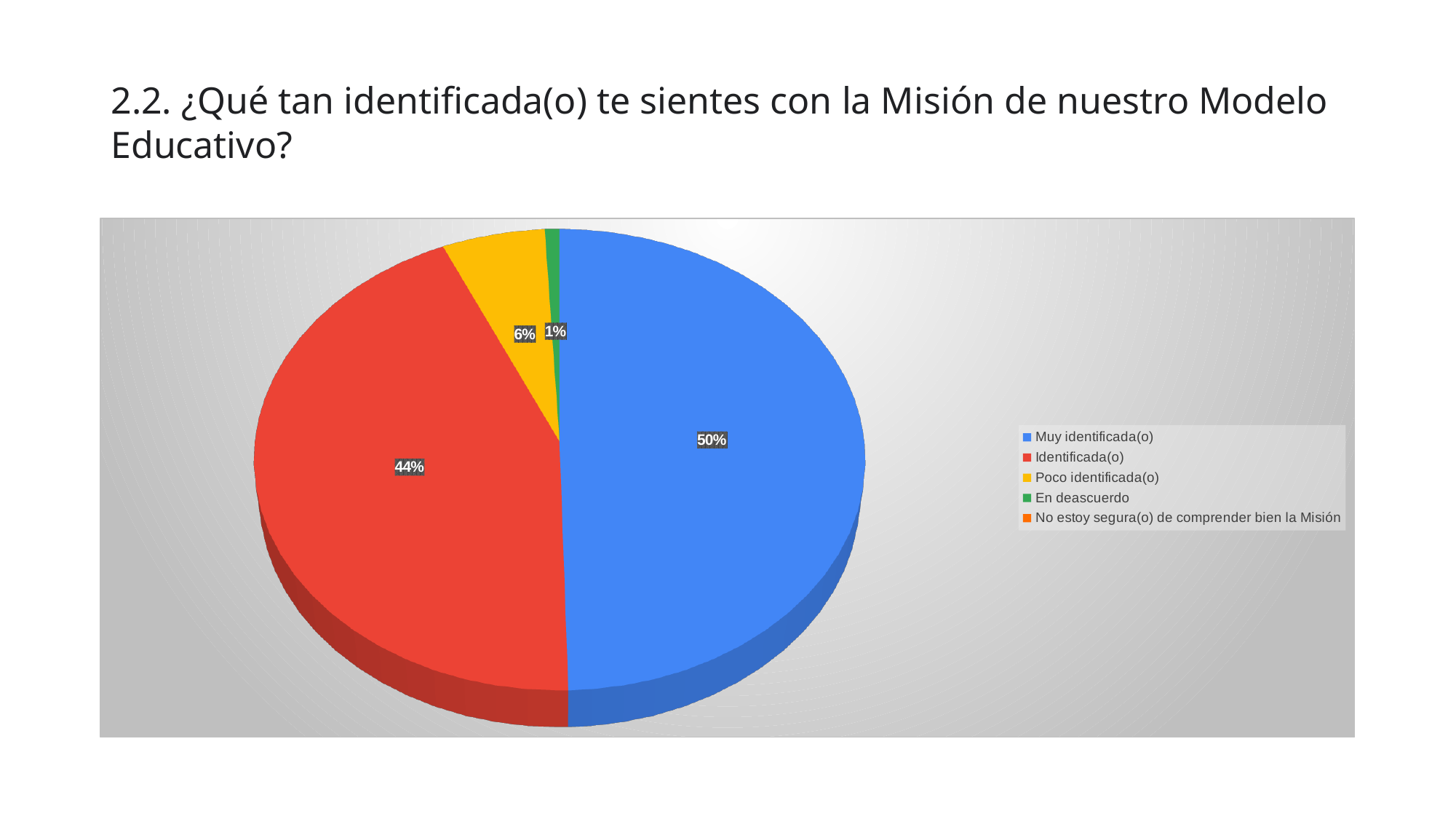
What share of the pie does "Muy identificada(o)" represent? 50% Which category has the largest slice of the pie? Muy identificada(o) What share of the pie does "En deascuerdo" represent? 1% What share of the pie does "Identificada(o)" represent? 44% What colour is the slice for "Muy identificada(o)"? blue What colour is the slice for "Identificada(o)"? red What is the difference in percentage points between "Muy identificada(o)" and "Identificada(o)"? 6% What kind of chart is shown on the slide? pie chart Which labelled slice of the pie is the smallest? En deascuerdo Which is larger, the slice for "Poco identificada(o)" or the slice for "En deascuerdo"? Poco identificada(o) How many entries does the legend list? 5